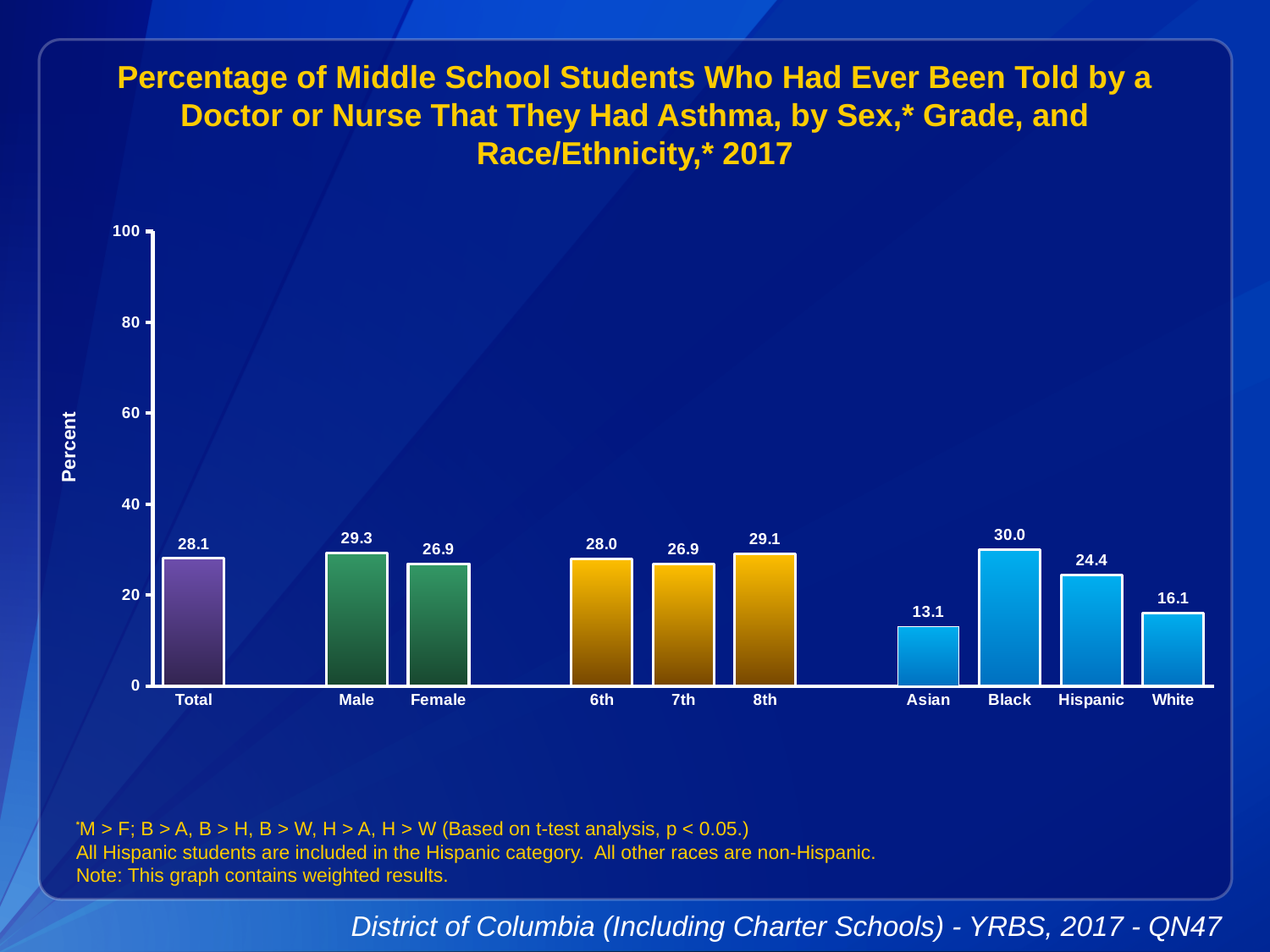
What is the value for Asian? 13.1 What kind of chart is this? bar chart What is the value for Total? 28.1 What is the difference between the values for Black and White? 13.9 What is the value for Male? 29.3 Which category has the highest value? Black Which is larger, the value for 8th or the value for 7th? 8th What is the label of the y axis? Percent What is the difference between the values for Male and Female? 2.4 How many categories are shown on the x axis? 10 What is the value for Hispanic? 24.4 Which category has the lowest value? Asian